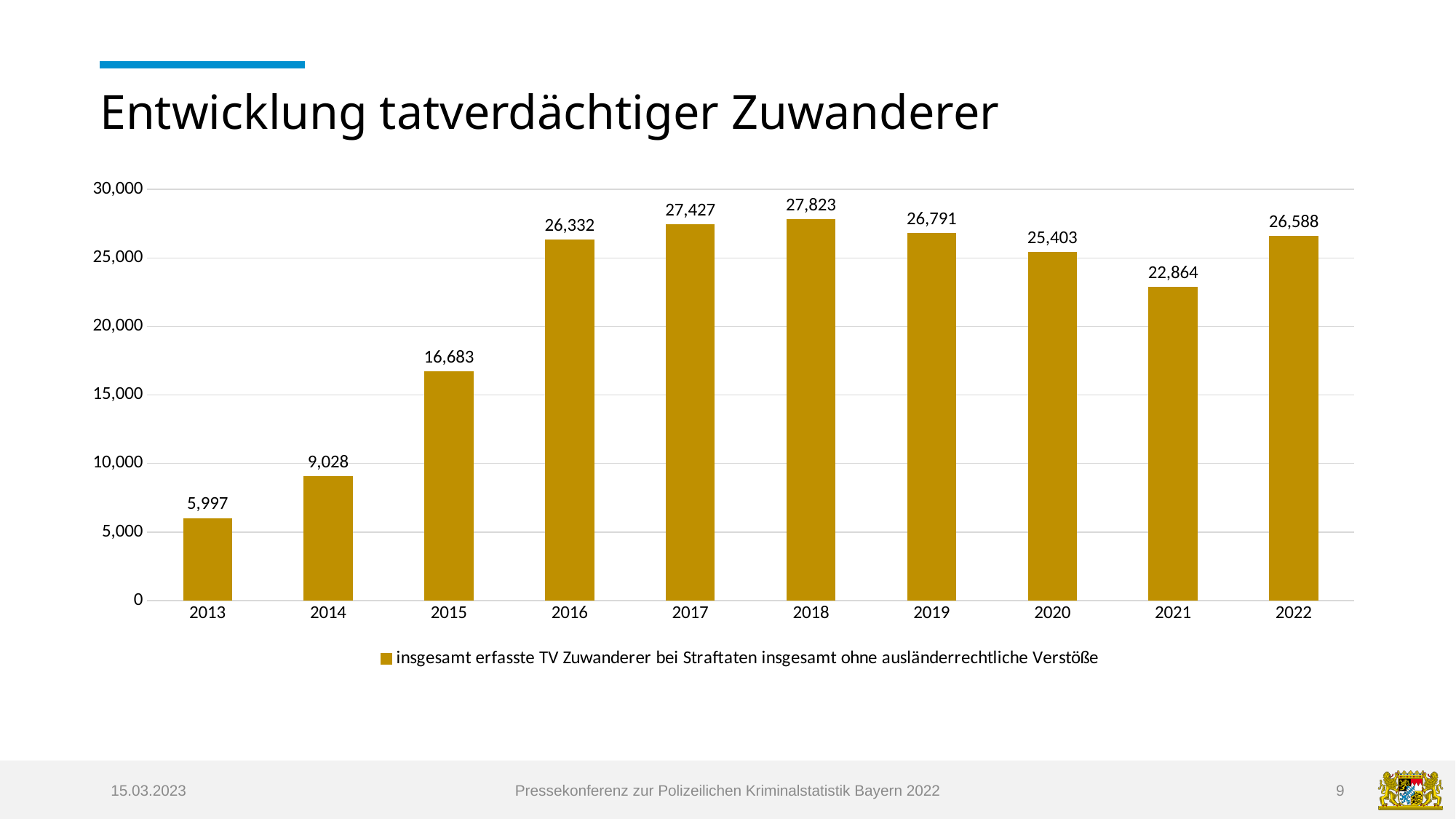
Which year has the lowest value? 2013 What is the value for 2013? 5,997 How many years are shown on the x axis? 10 What is the value for 2018? 27,823 Which year has the highest value? 2018 Is the value for 2015 greater or less than 15,000? greater How many series does the legend list? 1 What kind of chart is shown? bar chart Which is larger, the value for 2017 or the value for 2019? 2017 What is the difference between the values for 2022 and 2021? 3,724 What is the title of the chart? Entwicklung tatverdächtiger Zuwanderer What is the value for 2022? 26,588